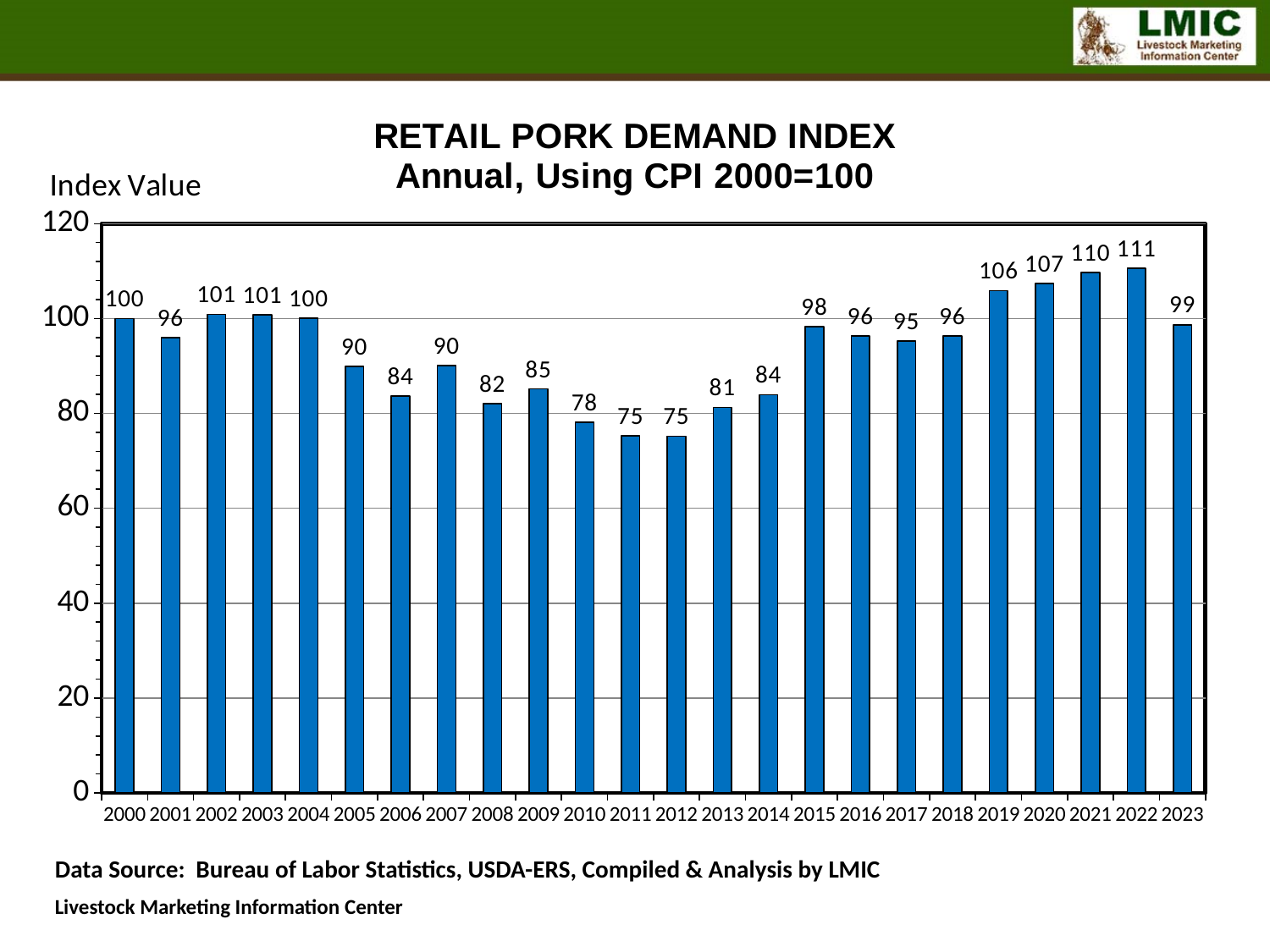
How many years are shown on the x axis? 24 What is the Retail Pork Demand Index value for 2022? 111 What is the label on the vertical axis of the chart? Index Value Do the index values rise or fall from 2018 to 2022? Rise What kind of chart is shown on the slide? Bar chart What is the lowest index value shown on the chart? 75 Which year has the highest index value? 2022 Which year has the larger index value, 2015 or 2019? 2019 What is the index value shown for 2023? 99 What is the index value shown for 2008? 82 Is the index value for 2010 greater or less than 80? less What is the difference between the index values for 2022 and 2012? 36